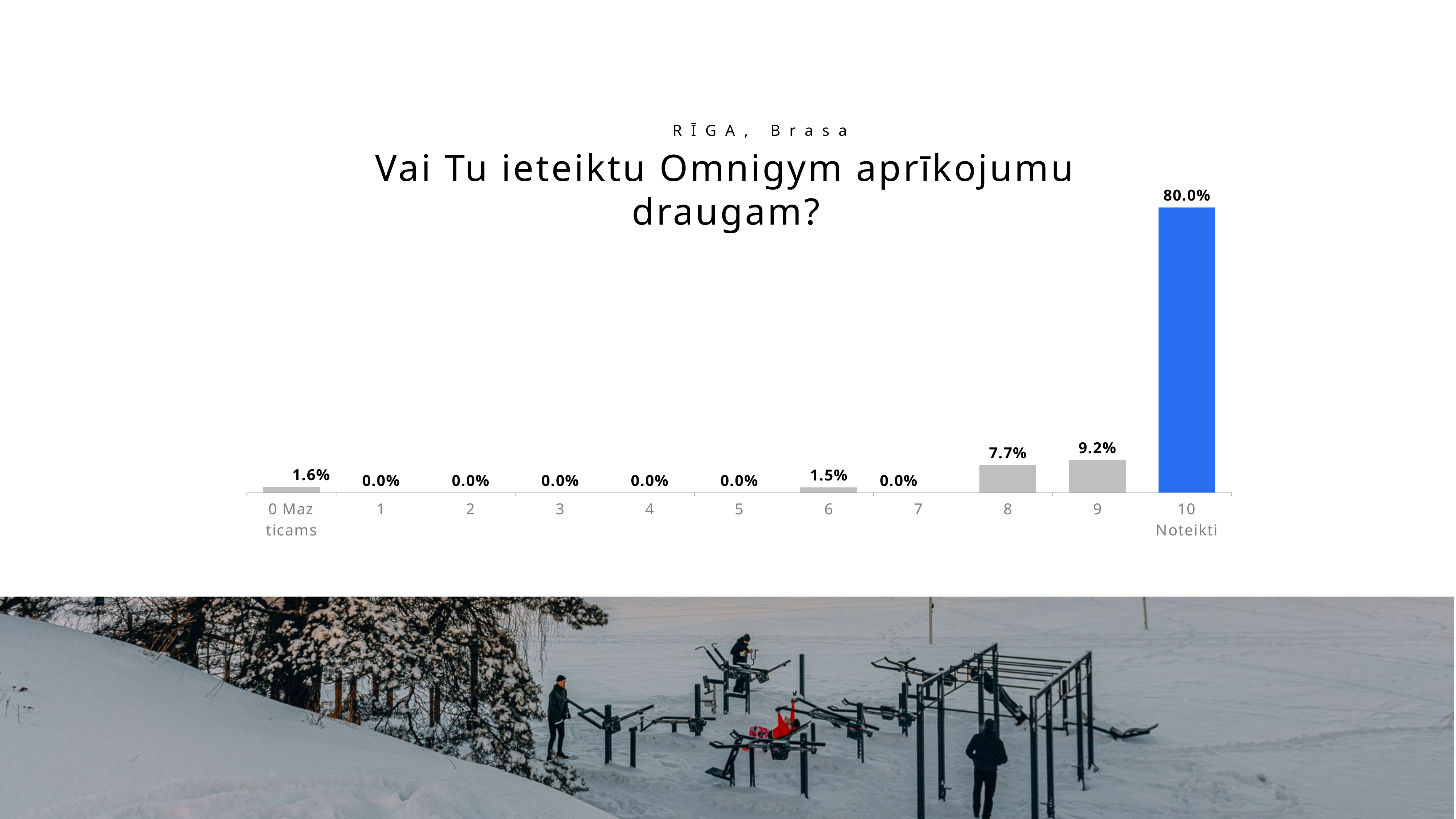
What is the difference between the values for category 10 Noteikti and category 9? 70.8% What is the value for category 0 Maz ticams? 1.6% Which is larger, the value for category 8 or the value for category 9? 9 What is the value for category 8? 7.7% Which category has the highest value? 10 Noteikti What is the value for category 9? 9.2% What is the title of the chart? Vai Tu ieteiktu Omnigym aprīkojumu draugam? What is the value for category 6? 1.5% What is the difference between the values for category 9 and category 8? 1.5% What is the value for category 10 Noteikti? 80.0% How many categories are shown on the x axis? 11 What kind of chart is shown on the slide? bar chart